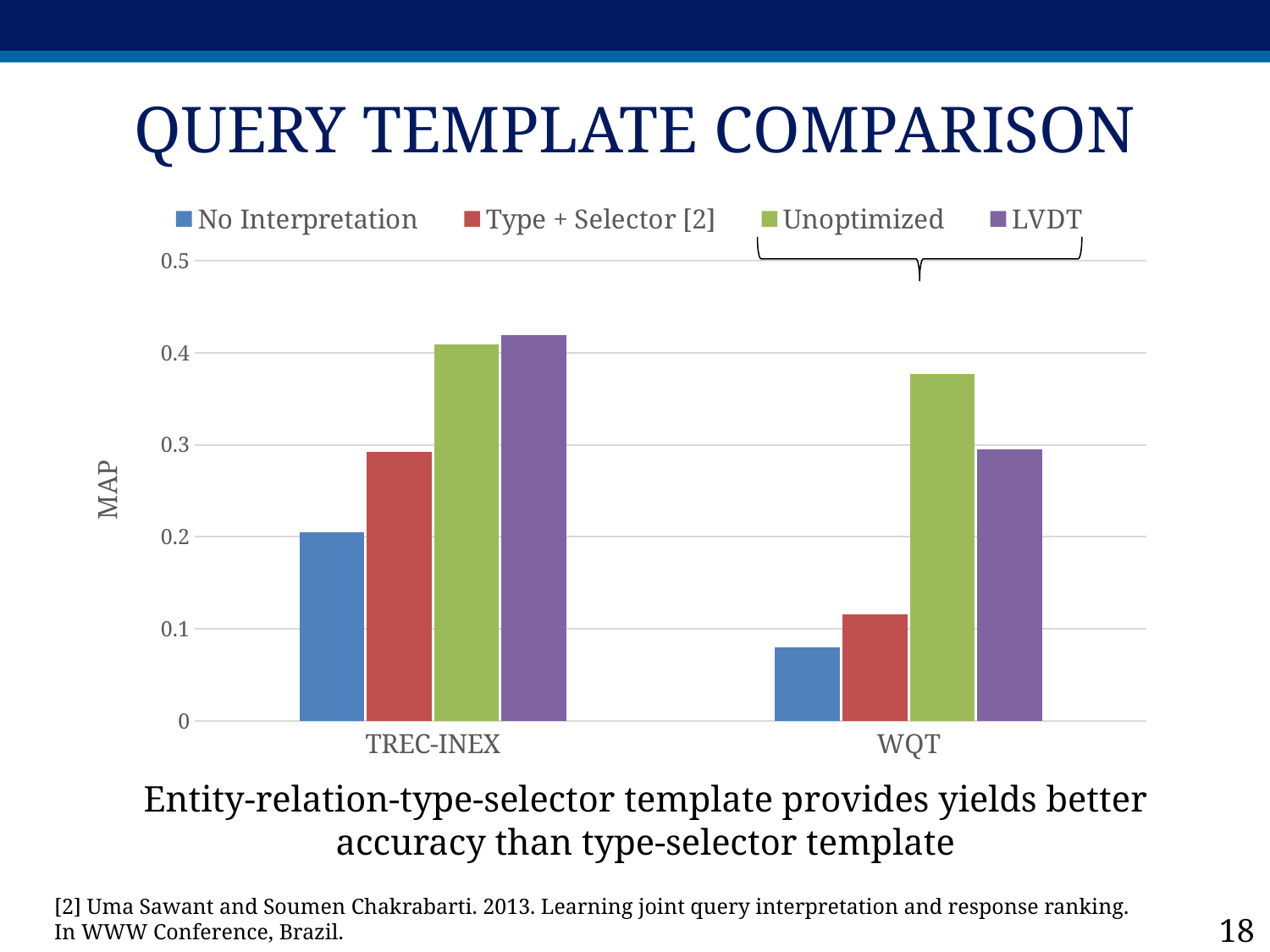
Which series has the highest MAP for WQT? Unoptimized Which series has the lowest MAP for TREC-INEX? No Interpretation Is the MAP value for LVDT on TREC-INEX greater or less than 0.4? greater How many categories are shown on the x axis? 2 Is the MAP value for No Interpretation on WQT greater or less than 0.1? less How many series does the legend list? 4 Is the MAP value for Type + Selector [2] on TREC-INEX greater or less than 0.2? greater Which series has the lowest MAP for WQT? No Interpretation What kind of chart is shown on the slide? bar chart For WQT, which is larger: the MAP for Unoptimized or for LVDT? Unoptimized What is the label of the y axis? MAP